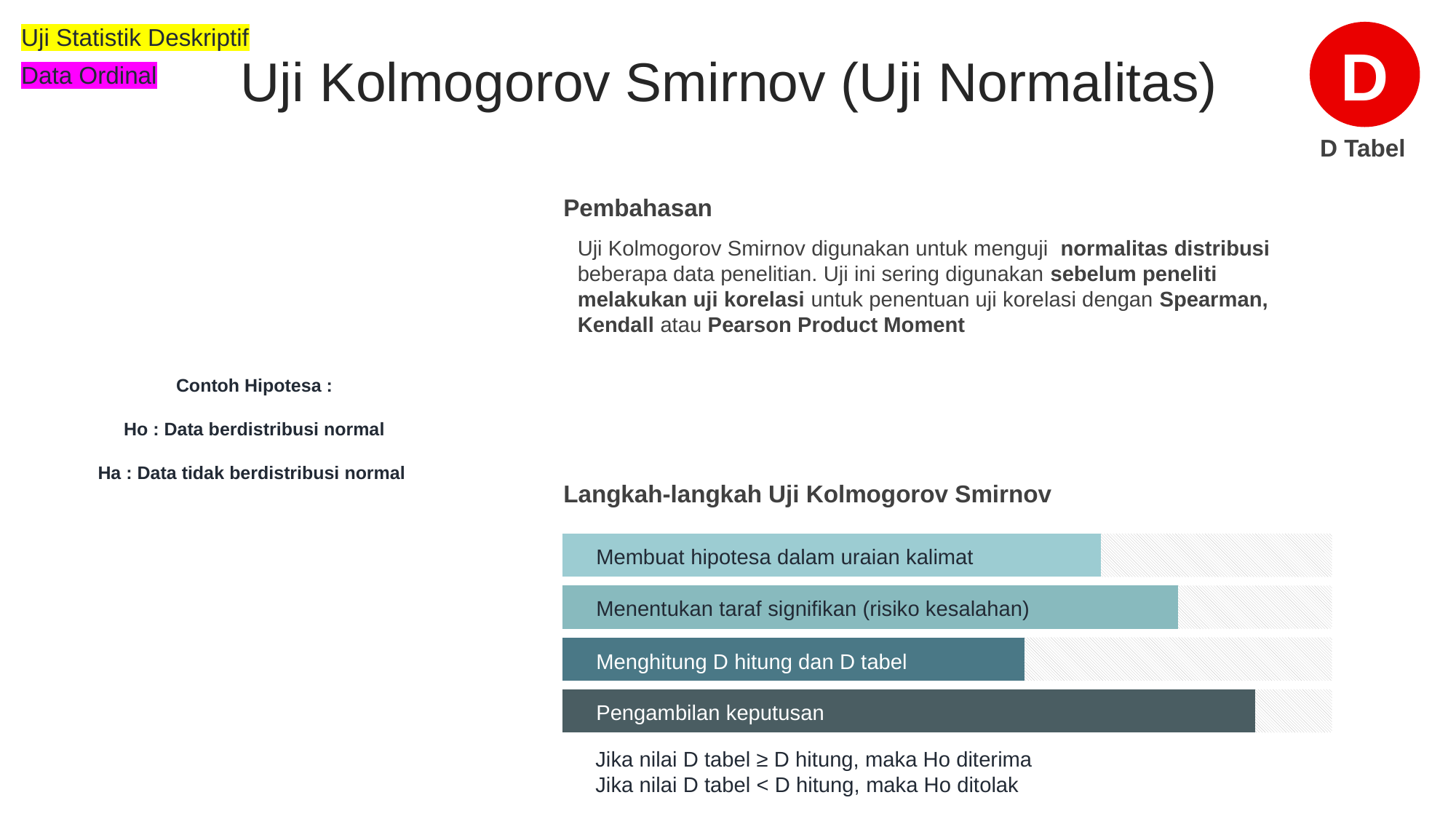
Which bar in the 'Langkah-langkah Uji Kolmogorov Smirnov' chart is the shortest? Menghitung D hitung dan D tabel Are the bars in the 'Langkah-langkah Uji Kolmogorov Smirnov' chart horizontal or vertical? horizontal What is the label of the last (bottom) bar in the 'Langkah-langkah Uji Kolmogorov Smirnov' chart? Pengambilan keputusan What is the label of the first (top) bar in the 'Langkah-langkah Uji Kolmogorov Smirnov' chart? Membuat hipotesa dalam uraian kalimat What is the heading above the bar chart on the slide? Langkah-langkah Uji Kolmogorov Smirnov In the 'Langkah-langkah Uji Kolmogorov Smirnov' chart, which bar is longer: 'Menghitung D hitung dan D tabel' or 'Pengambilan keputusan'? Pengambilan keputusan In the 'Langkah-langkah Uji Kolmogorov Smirnov' chart, which bar is longer: 'Membuat hipotesa dalam uraian kalimat' or 'Menentukan taraf signifikan (risiko kesalahan)'? Menentukan taraf signifikan (risiko kesalahan) Which bar in the 'Langkah-langkah Uji Kolmogorov Smirnov' chart is the longest? Pengambilan keputusan What kind of chart is shown under the heading 'Langkah-langkah Uji Kolmogorov Smirnov'? bar chart How many bars are shown in the 'Langkah-langkah Uji Kolmogorov Smirnov' chart? 4